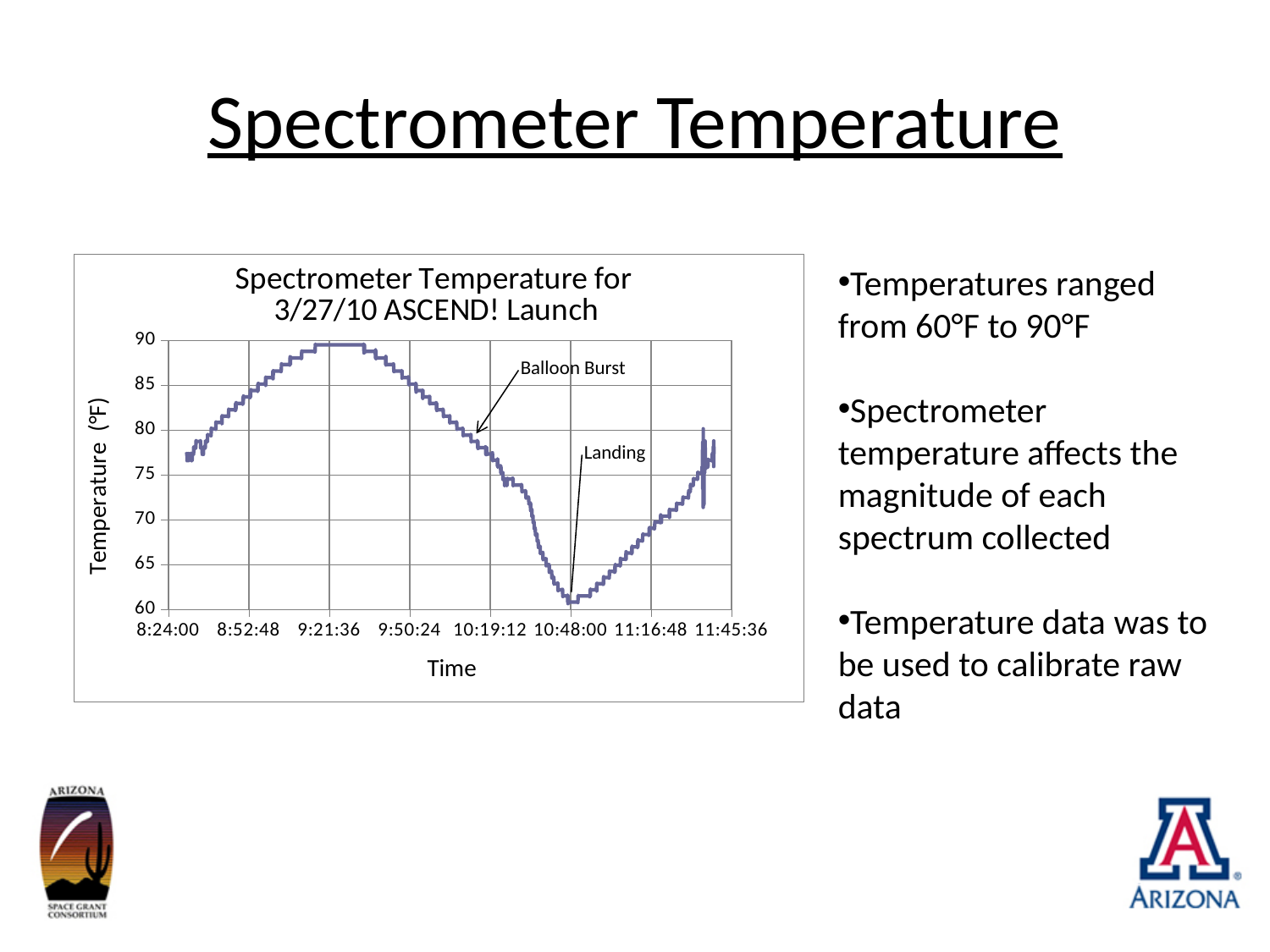
Is the temperature at 10:48:00 greater or less than 65? less Is the temperature at 8:52:48 greater or less than 80? greater Around which time tick does the temperature reach its lowest point? 10:48:00 Is the temperature at 11:16:48 greater or less than 70? less Does the temperature rise or fall between 10:48:00 and 11:45:36? rise What two events are annotated on the chart? Balloon Burst and Landing Does the temperature rise or fall between 9:21:36 and 10:48:00? fall What is the title of the chart? Spectrometer Temperature for 3/27/10 ASCEND! Launch What kind of chart is shown on the slide? Line chart